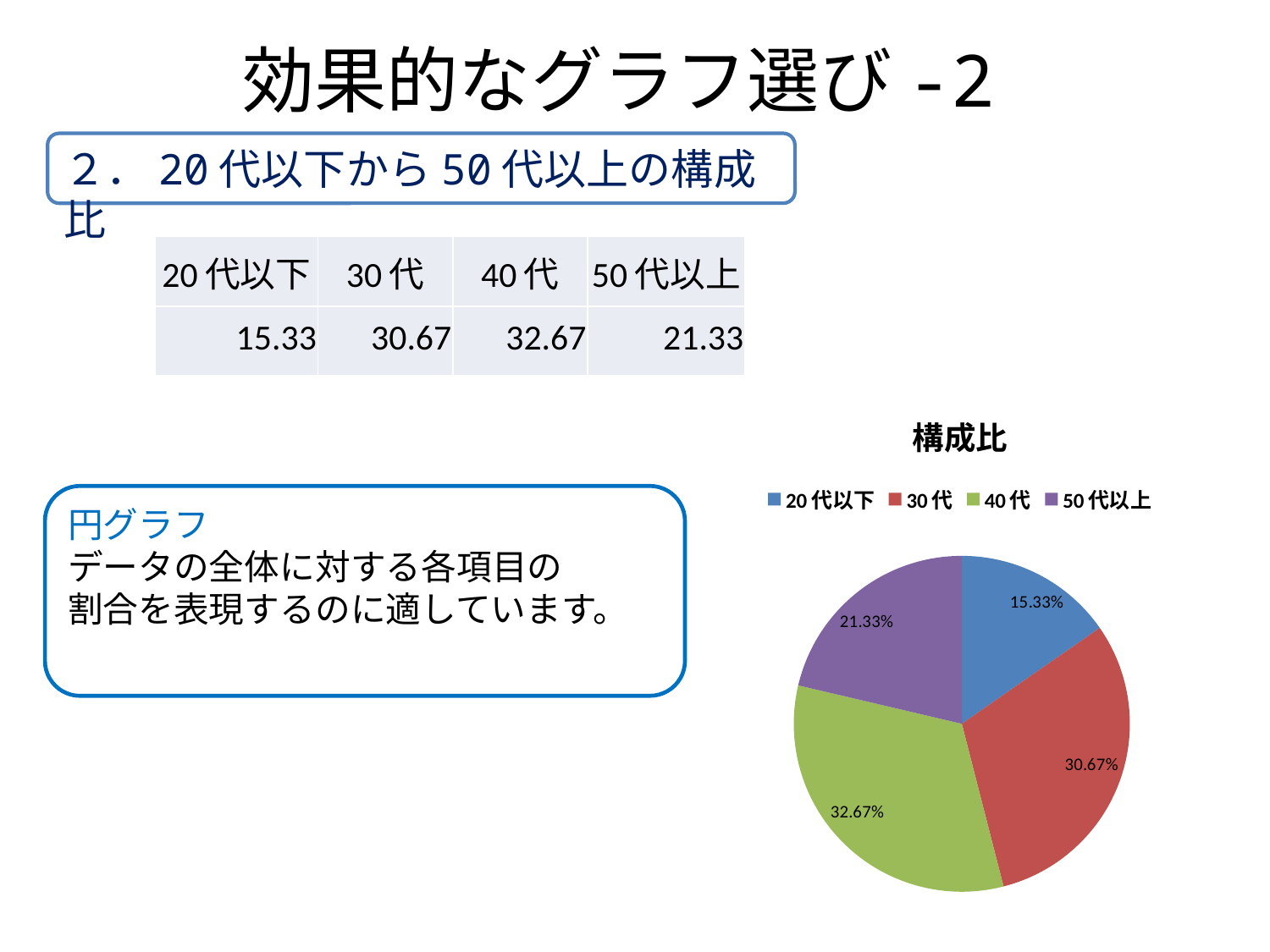
Which category has the smallest slice of the pie? 20代以下 What is the difference between the 40代 slice and the 20代以下 slice? 17.34% How many slices does the pie chart have? 4 What type of chart is shown on the slide? pie chart What is the title of the pie chart? 構成比 What colour is the 40代 slice in the pie chart? green Which category has the largest slice of the pie? 40代 What is the value shown for the 30代 slice? 30.67% Which is larger, the slice for 30代 or the slice for 50代以上? 30代 What is the value shown for the 20代以下 slice? 15.33% What is the value shown for the 40代 slice? 32.67% What is the value shown for the 50代以上 slice? 21.33%